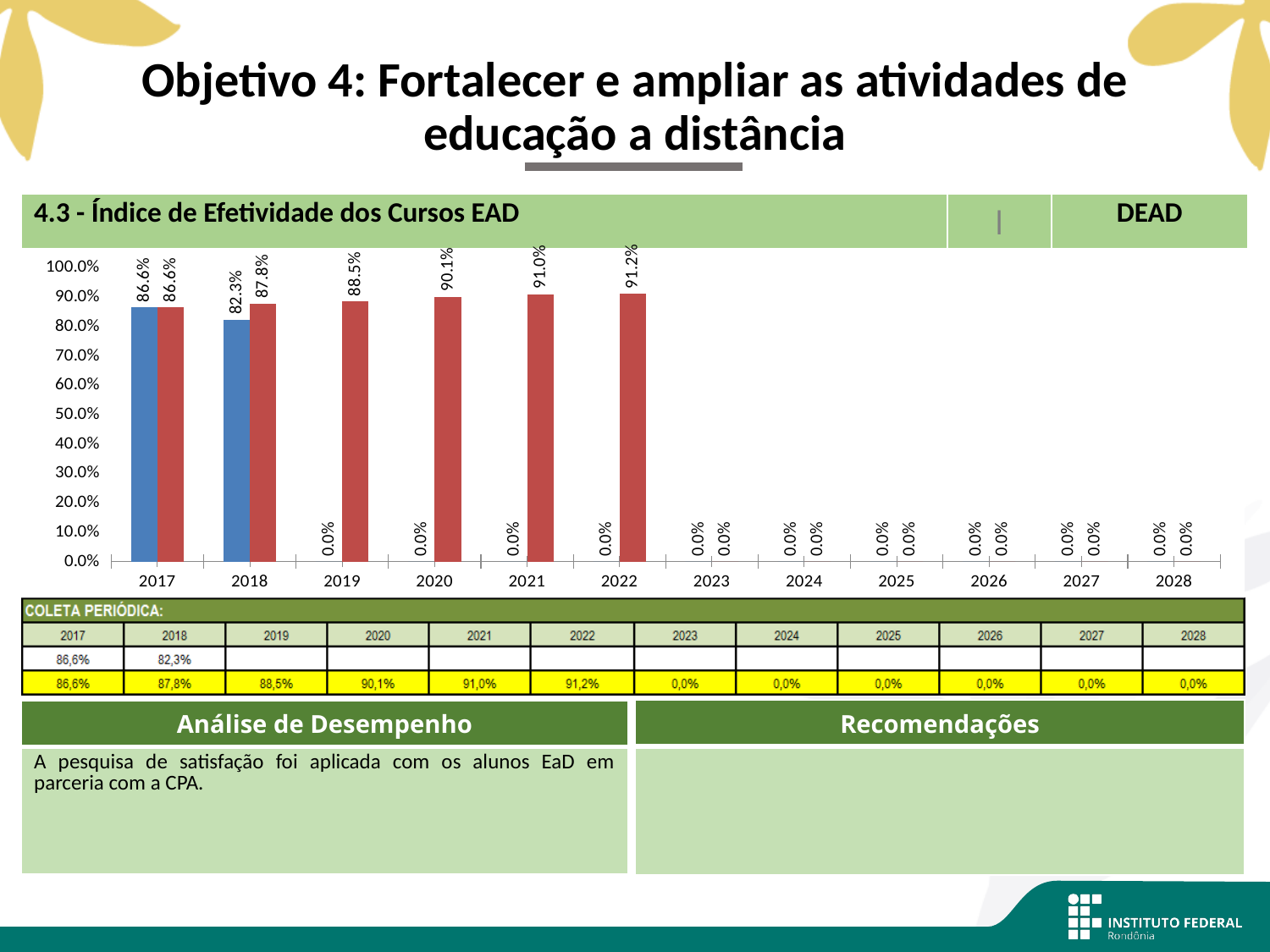
What is the value of the red bar for 2019? 88.5% How many years are shown on the x axis? 12 What kind of chart is shown on the slide? bar chart Do the red bar values rise or fall from 2017 to 2022? rise What is the difference between the red bar values for 2022 and 2017? 4.6% What is the difference between the red bar for 2018 and the blue bar for 2018? 5.5% Which is larger, the red bar for 2021 or the red bar for 2019? 2021 Which year has the highest red bar? 2022 Is the red bar for 2021 greater or less than 90.0%? greater What is the value of the red bar for 2022? 91.2% What is the value of the red bar for 2020? 90.1% What is the value of the blue bar for 2018? 82.3%